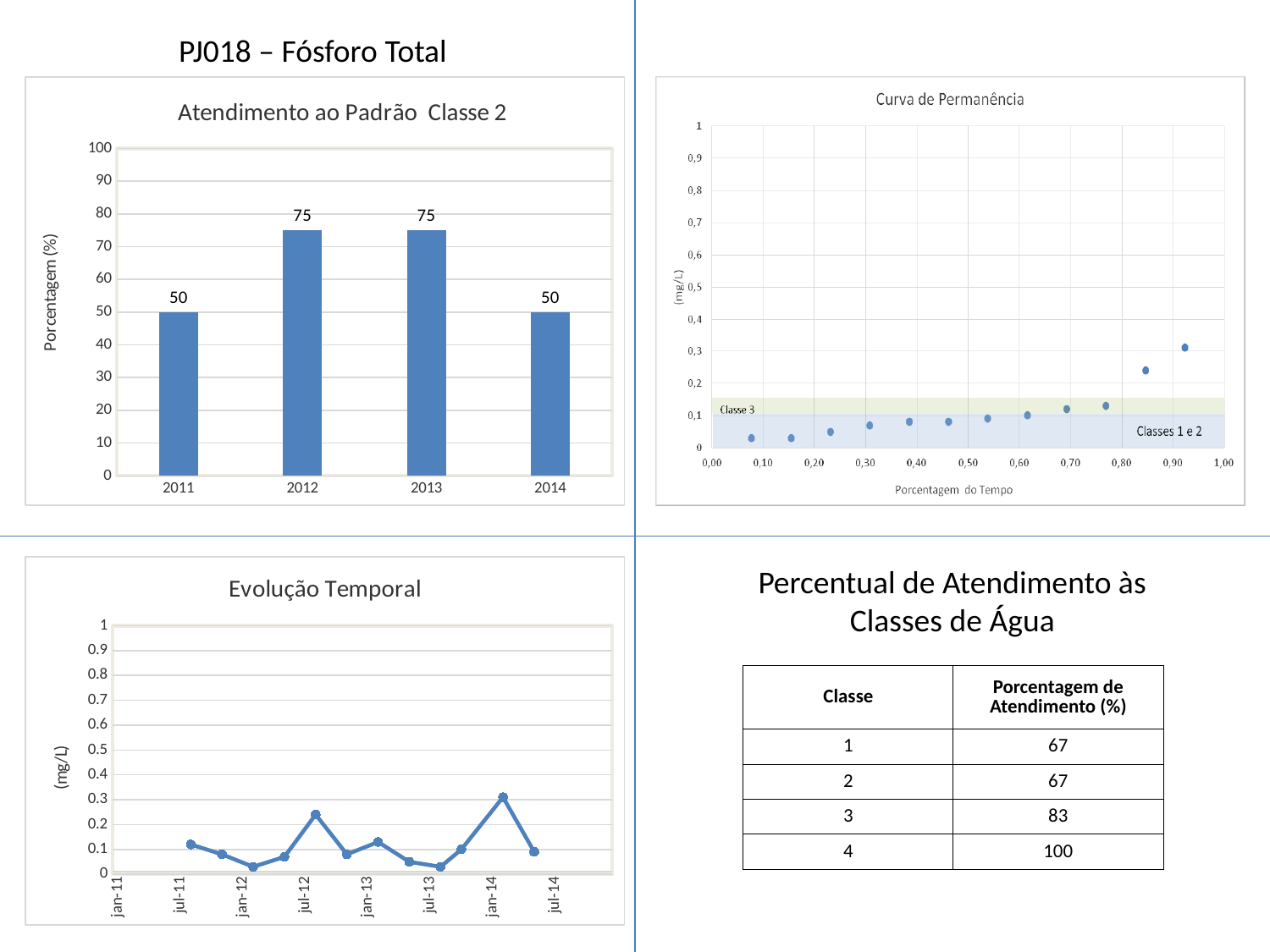
What kind of chart is 'Atendimento ao Padrão Classe 2'? bar chart How many years are shown on the x axis of the 'Atendimento ao Padrão Classe 2' chart? 4 In the 'Atendimento ao Padrão Classe 2' chart, what is the value for 2012? 75 What is the x-axis label of the 'Curva de Permanência' chart? Porcentagem do Tempo In the 'Atendimento ao Padrão Classe 2' chart, what is the value for 2014? 50 What kind of chart is 'Evolução Temporal'? line chart In the 'Atendimento ao Padrão Classe 2' chart, what is the difference between the values for 2013 and 2011? 25 What is the y-axis label of the 'Atendimento ao Padrão Classe 2' chart? Porcentagem (%) In the 'Curva de Permanência' chart, do the plotted values rise or fall as 'Porcentagem do Tempo' increases? rise In the 'Evolução Temporal' chart, is the value at jan-12 greater or less than 0.1? less In the 'Atendimento ao Padrão Classe 2' chart, which is larger, the value for 2012 or the value for 2014? 2012